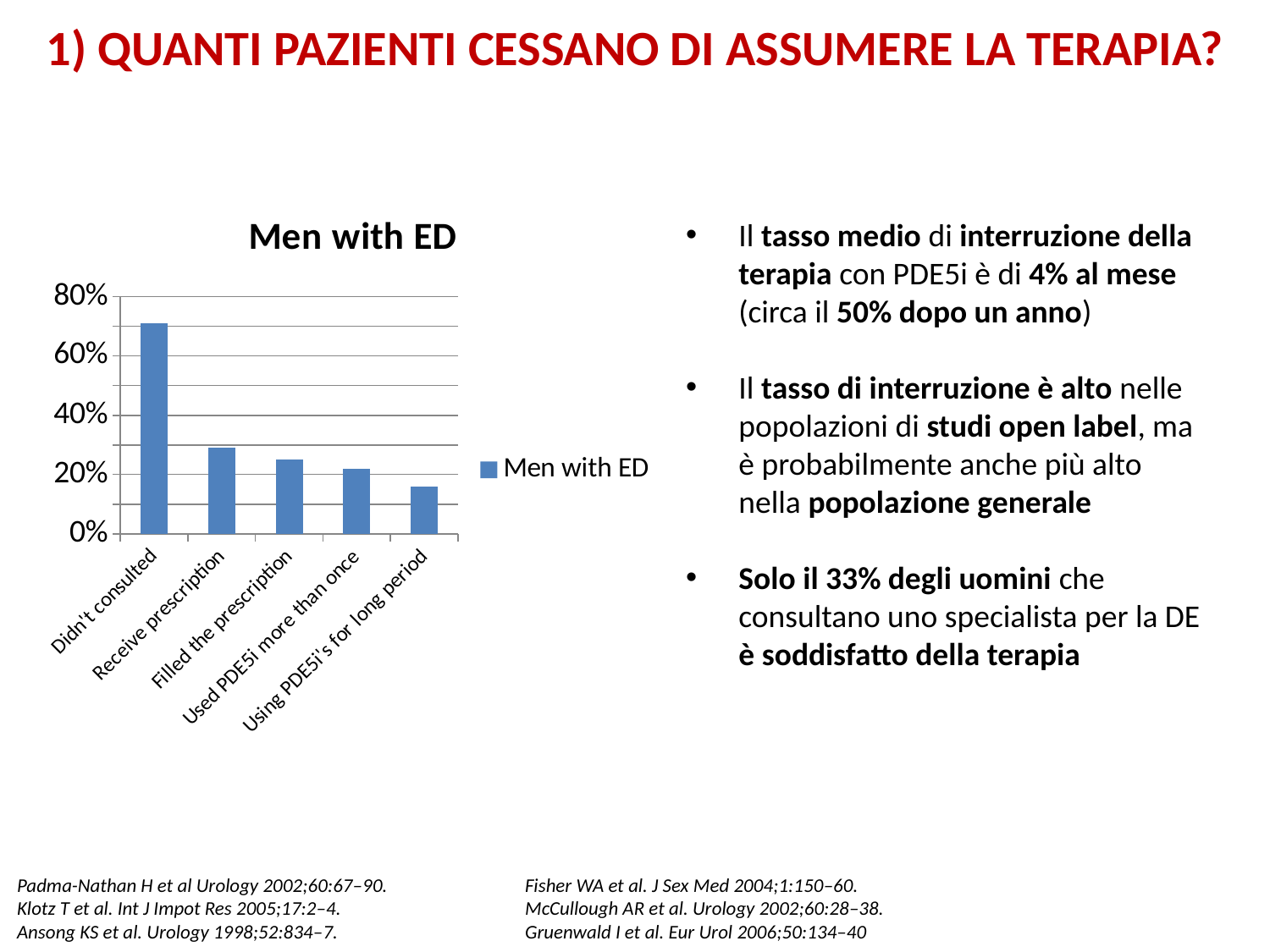
Which category has the lowest value in the chart? Using PDE5i's for long period What is the title of the chart? Men with ED Is the value for 'Didn't consulted' greater or less than 60%? greater Which is larger, the value for 'Didn't consulted' or the value for 'Receive prescription'? Didn't consulted How many series does the chart's legend list? 1 How many categories are shown on the x axis of the chart? 5 Is the value for 'Receive prescription' greater or less than 40%? less Do the values rise or fall moving from left to right along the x axis? fall What kind of chart is shown on the slide? bar chart Which category has the highest value in the chart? Didn't consulted Is the value for 'Using PDE5i's for long period' greater or less than 20%? less